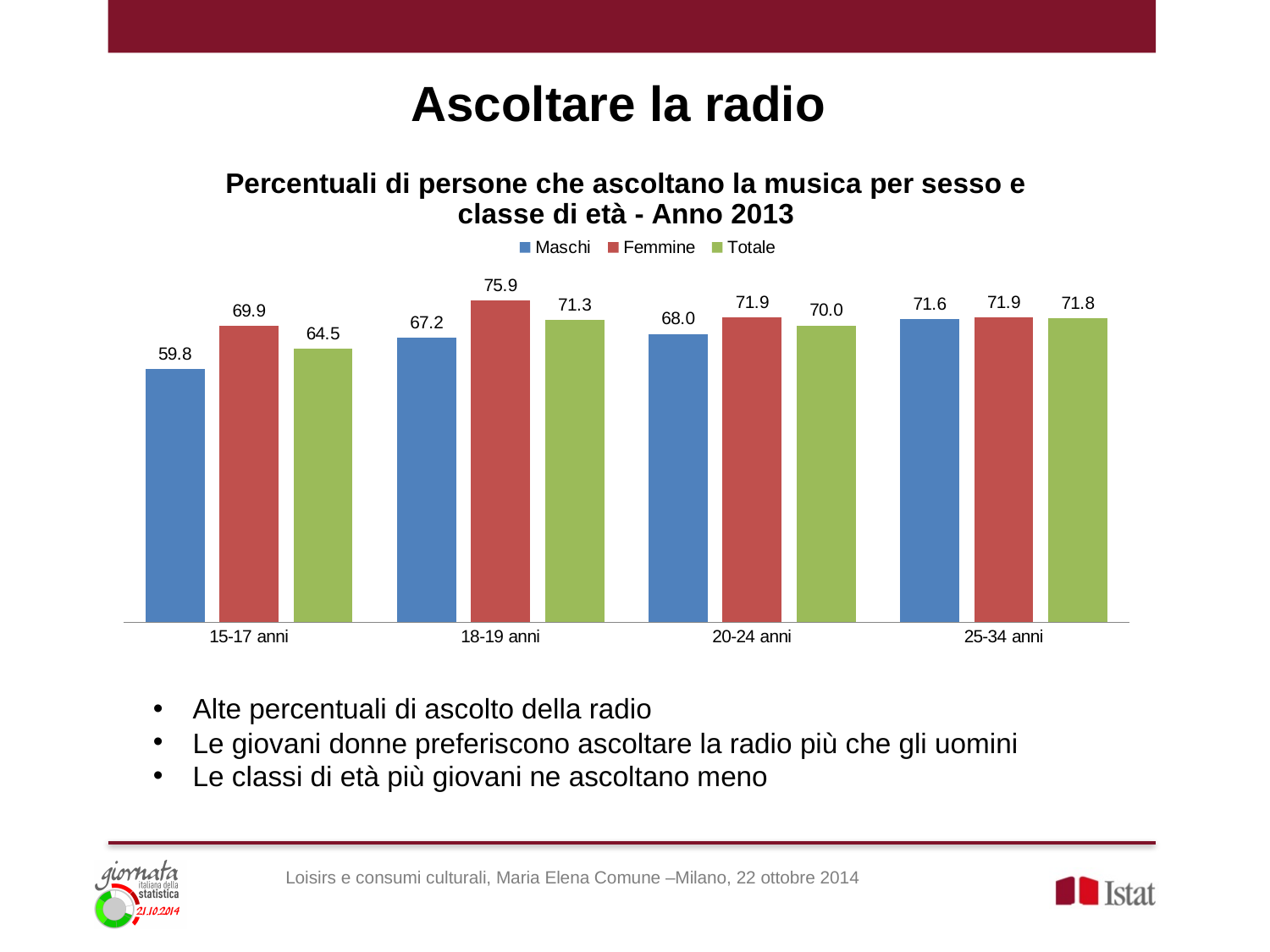
What kind of chart is shown on the slide? Bar chart Which age group has the lowest Maschi value? 15-17 anni Which colour represents the Totale series in the chart? Green What is the difference between the Femmine and Maschi values for 15-17 anni? 10.1 Which is larger for 20-24 anni, the Maschi value or the Femmine value? Femmine Which age group has the highest Femmine value? 18-19 anni How many series does the legend list? 3 How many age groups are shown on the x axis? 4 Do the Maschi values rise or fall from 15-17 anni to 25-34 anni? Rise What is the Totale value for the 25-34 anni age group? 71.8 What is the value for Femmine in the 18-19 anni age group? 75.9 What is the value for Maschi in the 15-17 anni age group? 59.8